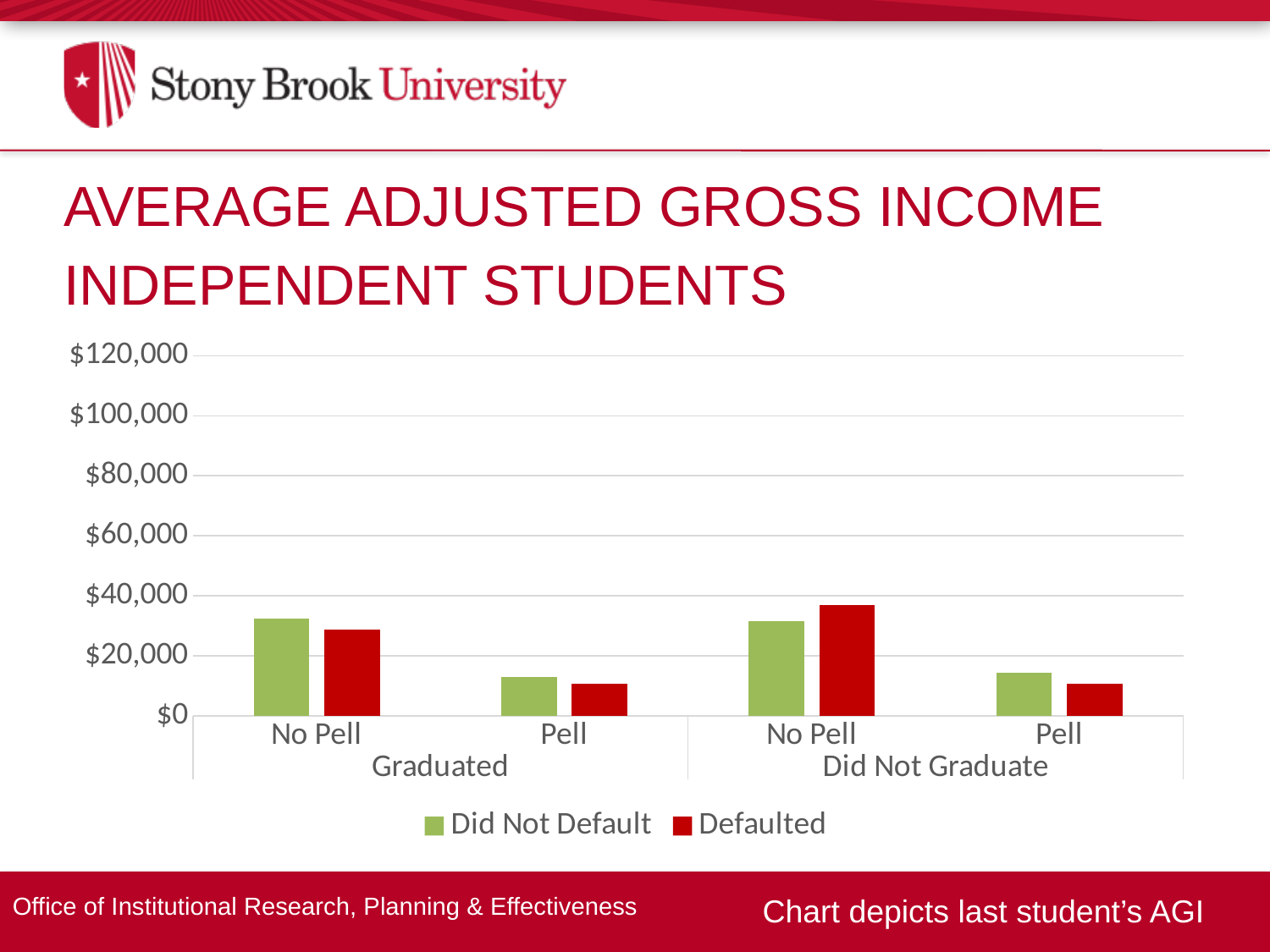
What colour represents the Defaulted series? Red How many category groups (pairs of bars) are plotted along the x axis? 4 Is the Did Not Default value for No Pell students who Graduated greater or less than $20,000? greater What kind of chart is shown on the slide? Bar chart What are the two series named in the legend? Did Not Default and Defaulted For No Pell students who Did Not Graduate, which is larger: Did Not Default or Defaulted? Defaulted How many series does the legend list? 2 Is the Defaulted value for No Pell students who Did Not Graduate greater or less than $40,000? less Among students who Graduated, which is larger for Did Not Default: No Pell or Pell? No Pell Is the Did Not Default value for Pell students who Graduated greater or less than $20,000? less Which bar is the highest on the chart? Defaulted, No Pell, Did Not Graduate